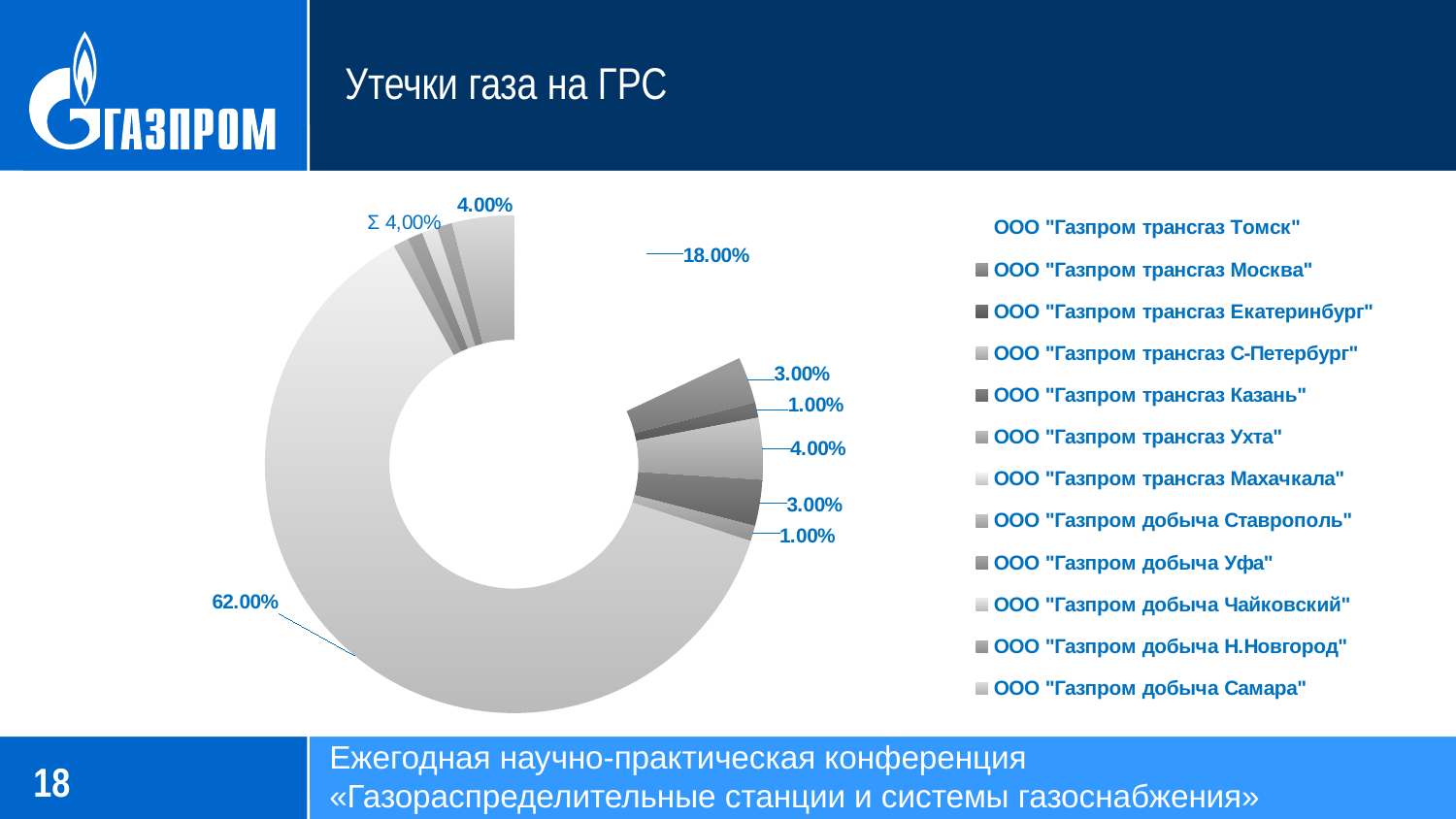
What kind of chart is shown on the slide? Doughnut (pie) chart What is the value of the largest slice in the chart? 62.00% What is the last entry listed in the chart's legend? ООО "Газпром добыча Самара" How many data labels on the chart show a value of 3.00%? 2 What is the title of the chart on the slide? Утечки газа на ГРС Is the largest slice of the chart greater or less than 50%? greater What is the value of the second-largest slice in the chart? 18.00% Which is larger: the slice labelled 18.00% or the slice labelled 4.00%? 18.00% What is the difference between the largest slice (62.00%) and the second-largest slice (18.00%)? 44.00% What is the smallest data label value shown on the chart? 1.00% How many entries does the chart's legend list? 12 What value is shown in the summary label (Σ) for the group of small slices at the top left of the chart? 4,00%